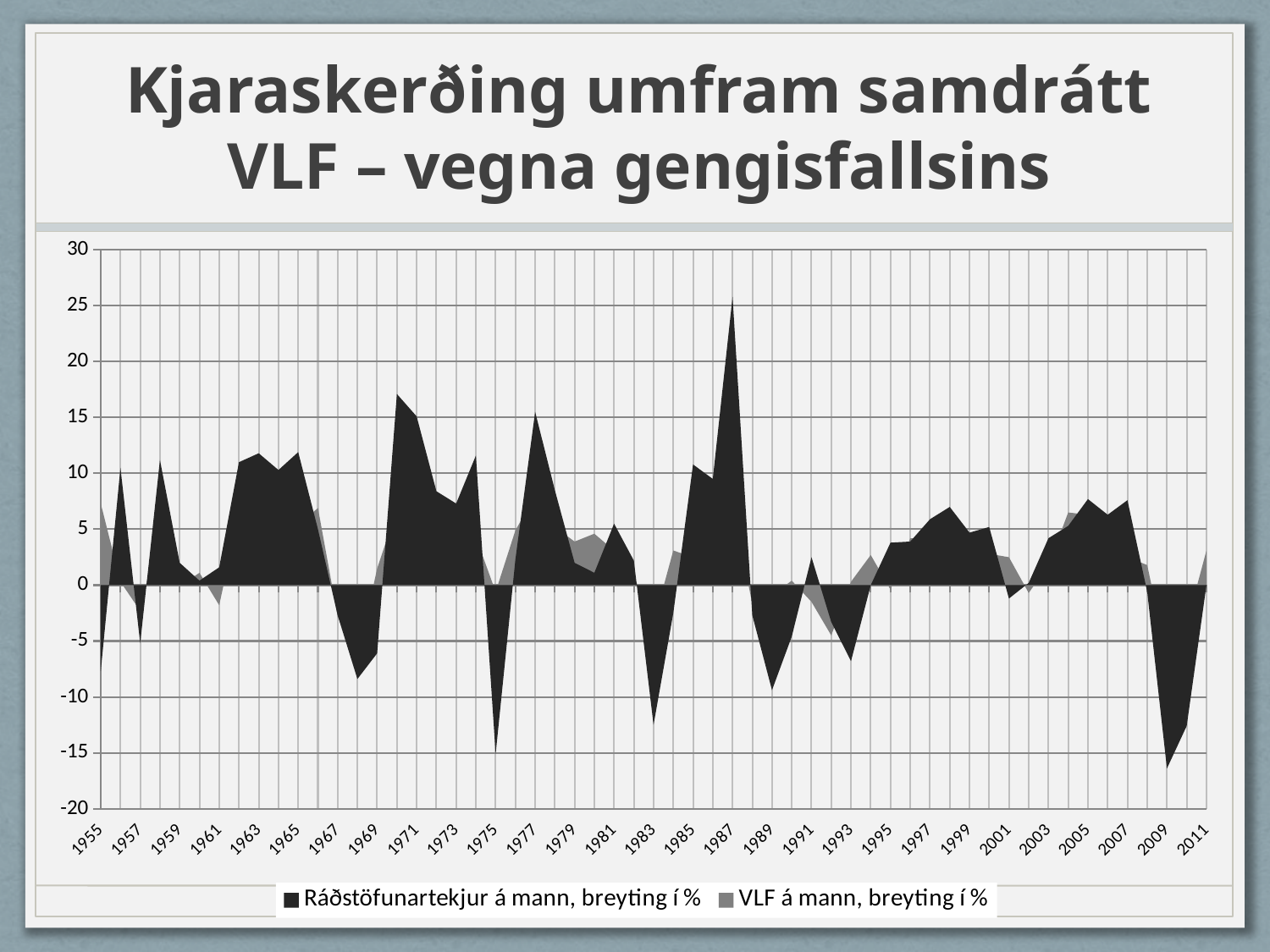
What is the title of the chart's slide? Kjaraskerðing umfram samdrátt VLF – vegna gengisfallsins What is the highest value shown on the vertical axis? 30 In which year does the series 'Ráðstöfunartekjur á mann, breyting í %' reach its lowest value? 2009 Is the value for 'Ráðstöfunartekjur á mann, breyting í %' in 1975 greater or less than -10? less Is the value for 'Ráðstöfunartekjur á mann, breyting í %' in 2009 greater or less than -10? less Is the value for 'Ráðstöfunartekjur á mann, breyting í %' in 1987 greater or less than 20? greater In which year does the series 'Ráðstöfunartekjur á mann, breyting í %' reach its highest value? 1987 How many series does the legend list? 2 Which is larger, the value for 'Ráðstöfunartekjur á mann, breyting í %' in 1987 or in 1971? 1987 What kind of chart is shown on the slide? area chart